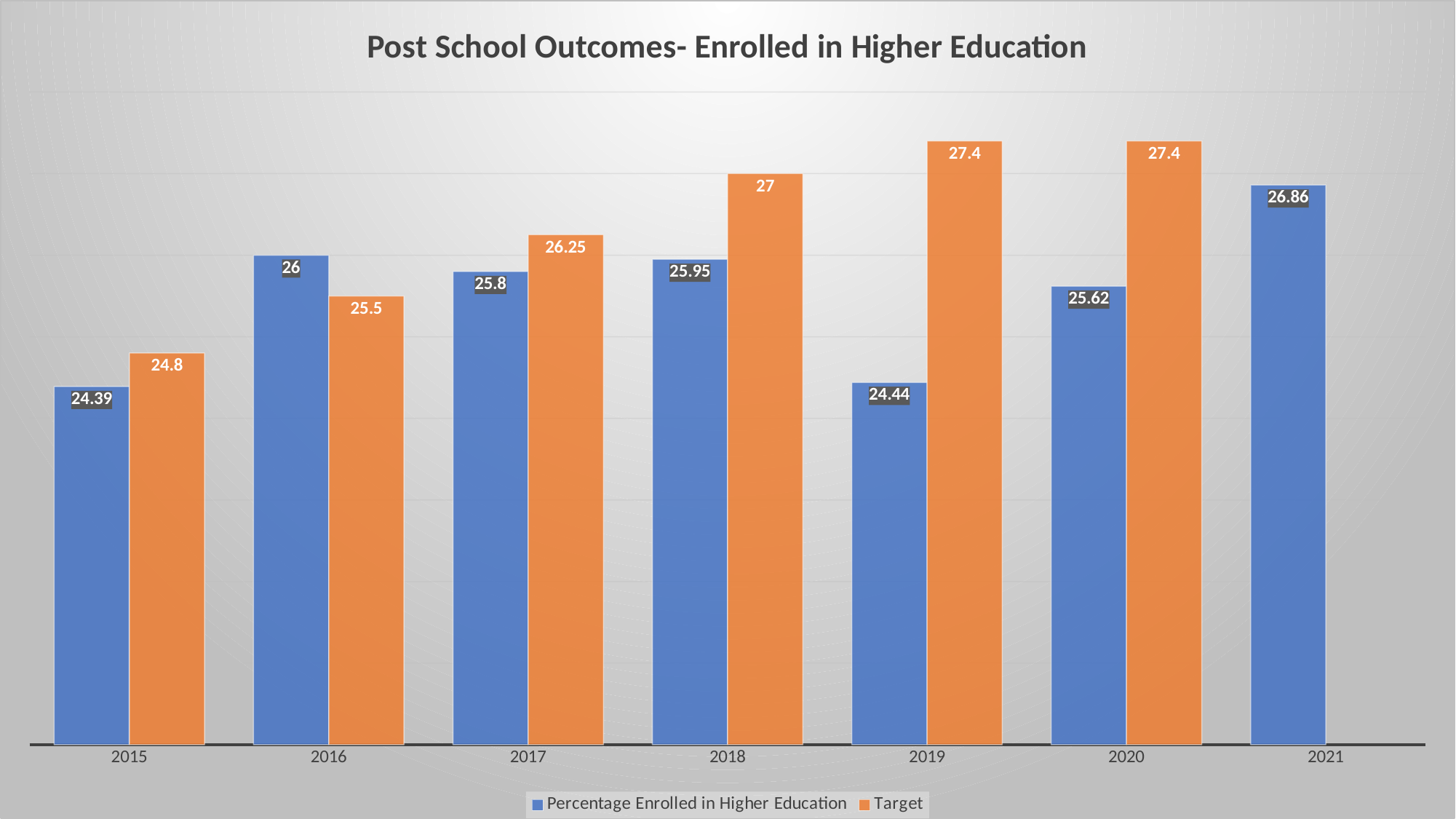
Which year has the lowest Target value? 2015 Which year has the highest Percentage Enrolled in Higher Education? 2021 Which year has the lowest Percentage Enrolled in Higher Education? 2015 What is the Target value for 2017? 26.25 What is the difference between the Target and the Percentage Enrolled in Higher Education in 2019? 2.96 How many years are shown on the x axis? 7 What is the Percentage Enrolled in Higher Education for 2021? 26.86 How many series does the legend list? 2 In 2016, which is larger: the Percentage Enrolled in Higher Education or the Target? Percentage Enrolled in Higher Education What is the title of the chart? Post School Outcomes- Enrolled in Higher Education What is the Percentage Enrolled in Higher Education for 2018? 25.95 What kind of chart is shown on the slide? Bar chart